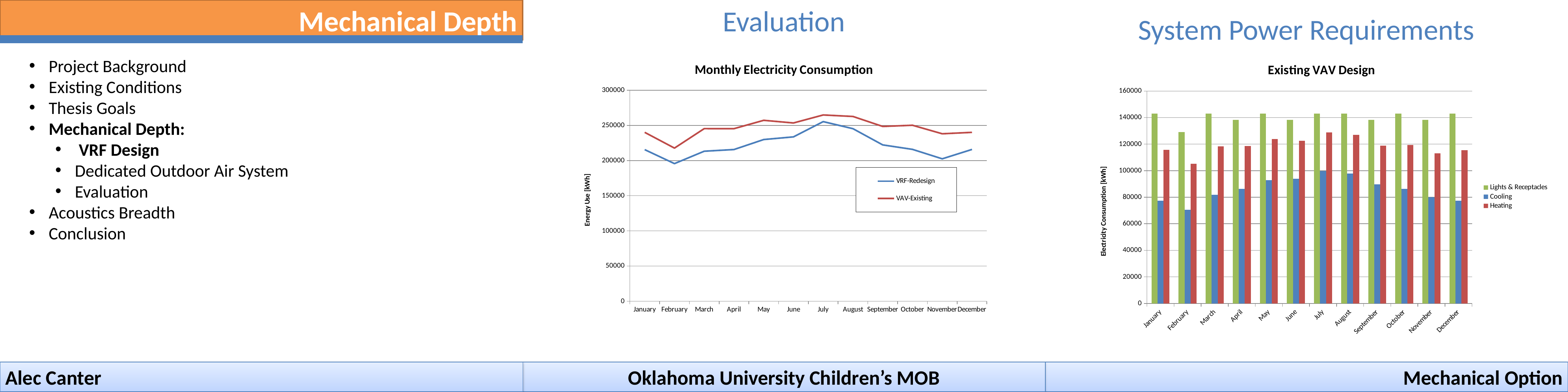
In the 'Monthly Electricity Consumption' chart, which series is higher in July, VRF-Redesign or VAV-Existing? VAV-Existing How many series does the legend of the 'Monthly Electricity Consumption' chart list? 2 In the 'Monthly Electricity Consumption' chart, which month has the lowest VAV-Existing value? February In the 'Monthly Electricity Consumption' chart, is the VRF-Redesign value for February greater or less than 200000? less In the 'Existing VAV Design' chart, which series is larger in July, Lights & Receptacles or Cooling? Lights & Receptacles How many series does the legend of the 'Existing VAV Design' chart list? 3 What type of chart is the 'Monthly Electricity Consumption' chart? line chart What type of chart is the 'Existing VAV Design' chart? bar chart In the 'Monthly Electricity Consumption' chart, which month has the highest VRF-Redesign value? July In the 'Existing VAV Design' chart, which month has the lowest Cooling value? February How many months are shown on the x axis of the 'Existing VAV Design' chart? 12 In the 'Existing VAV Design' chart, is the Heating value for January greater or less than 100000? greater